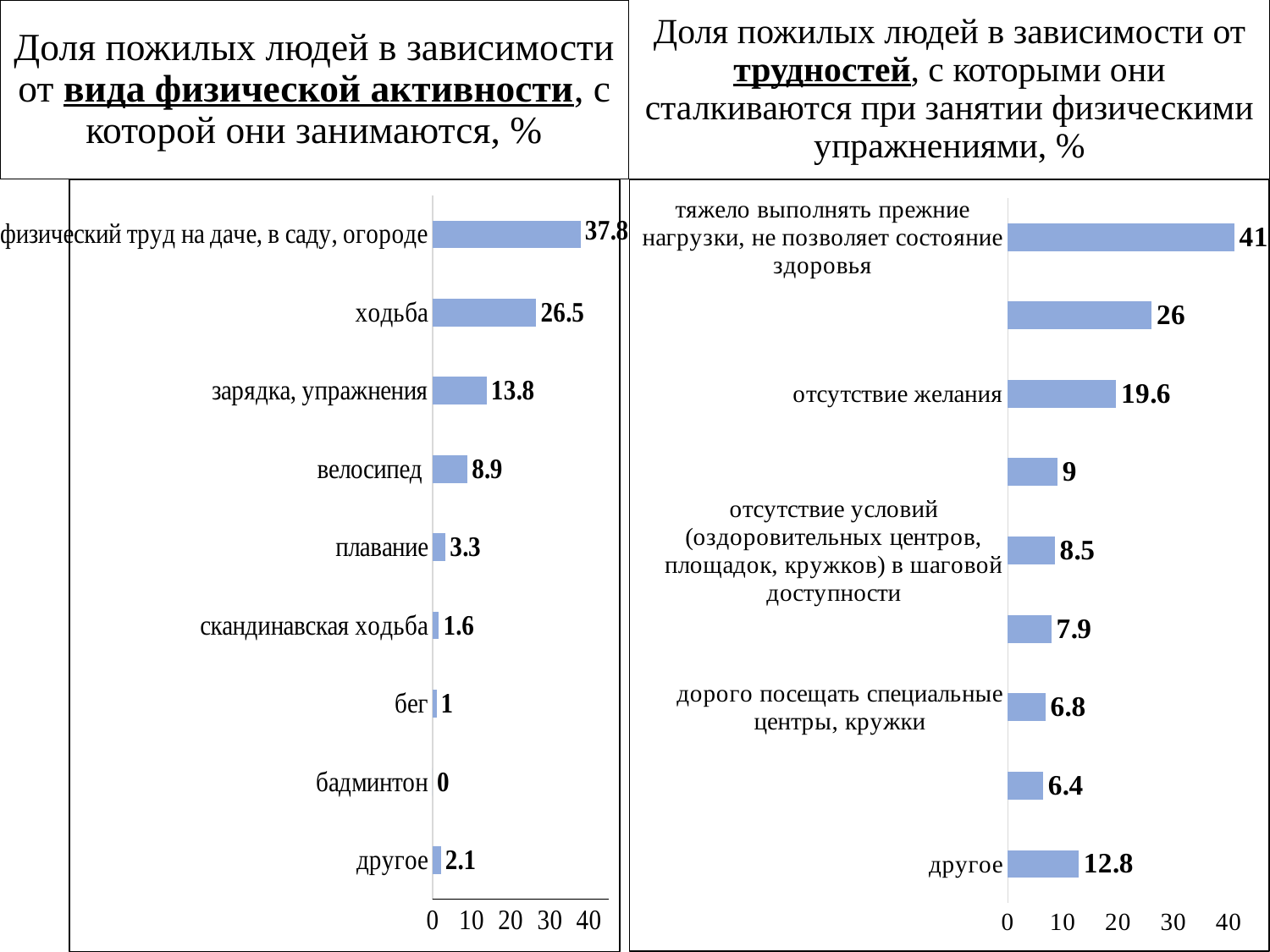
On the right chart (share of elderly people by difficulties with physical exercise), what is the difference between the values for 'отсутствие желания' and 'другое'? 6.8 On the left chart (share of elderly people by type of physical activity), what is the difference between the values for 'ходьба' and 'зарядка, упражнения'? 12.7 What type of chart is used on the right side of the slide? bar chart On the left chart (share of elderly people by type of physical activity), what is the value for 'скандинавская ходьба'? 1.6 On the right chart (share of elderly people by difficulties with physical exercise), what is the value for 'отсутствие желания'? 19.6 On the left chart (share of elderly people by type of physical activity), which category has the highest value? физический труд на даче, в саду, огороде On the left chart (share of elderly people by type of physical activity), how many categories are shown? 9 On the right chart (share of elderly people by difficulties with physical exercise), what is the highest value shown? 41 On the left chart (share of elderly people by type of physical activity), what is the value for 'ходьба'? 26.5 On the left chart (share of elderly people by type of physical activity), which is larger: 'плавание' or 'велосипед'? велосипед On the right chart (share of elderly people by difficulties with physical exercise), what is the value for 'дорого посещать специальные центры, кружки'? 6.8 On the left chart (share of elderly people by type of physical activity), which category has the lowest value? бадминтон